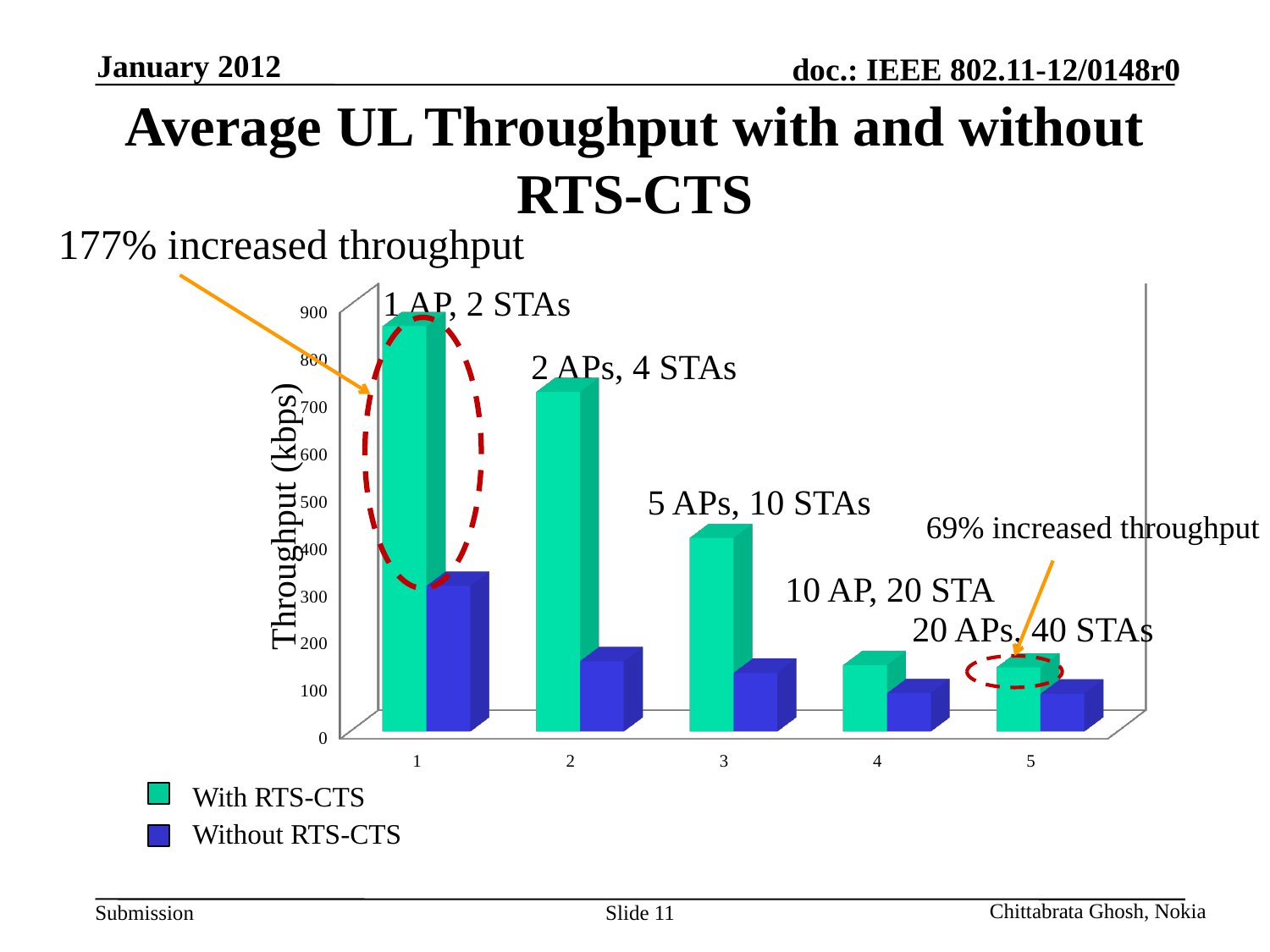
Do the With RTS-CTS values rise or fall from category 1 to category 5? fall How many series does the legend list? 2 Is the Without RTS-CTS value for category 1 greater or less than 200? greater Is the With RTS-CTS value for category 1 greater or less than 800? greater What is the title of the chart? Average UL Throughput with and without RTS-CTS What is the label on the vertical axis? Throughput (kbps) For category 1, which is larger: With RTS-CTS or Without RTS-CTS? With RTS-CTS Is the With RTS-CTS value for category 3 greater or less than 500? less What kind of chart is shown on the slide? bar chart How many categories are shown along the x axis? 5 For which category is the With RTS-CTS value highest? 1 For which category is the Without RTS-CTS value highest? 1